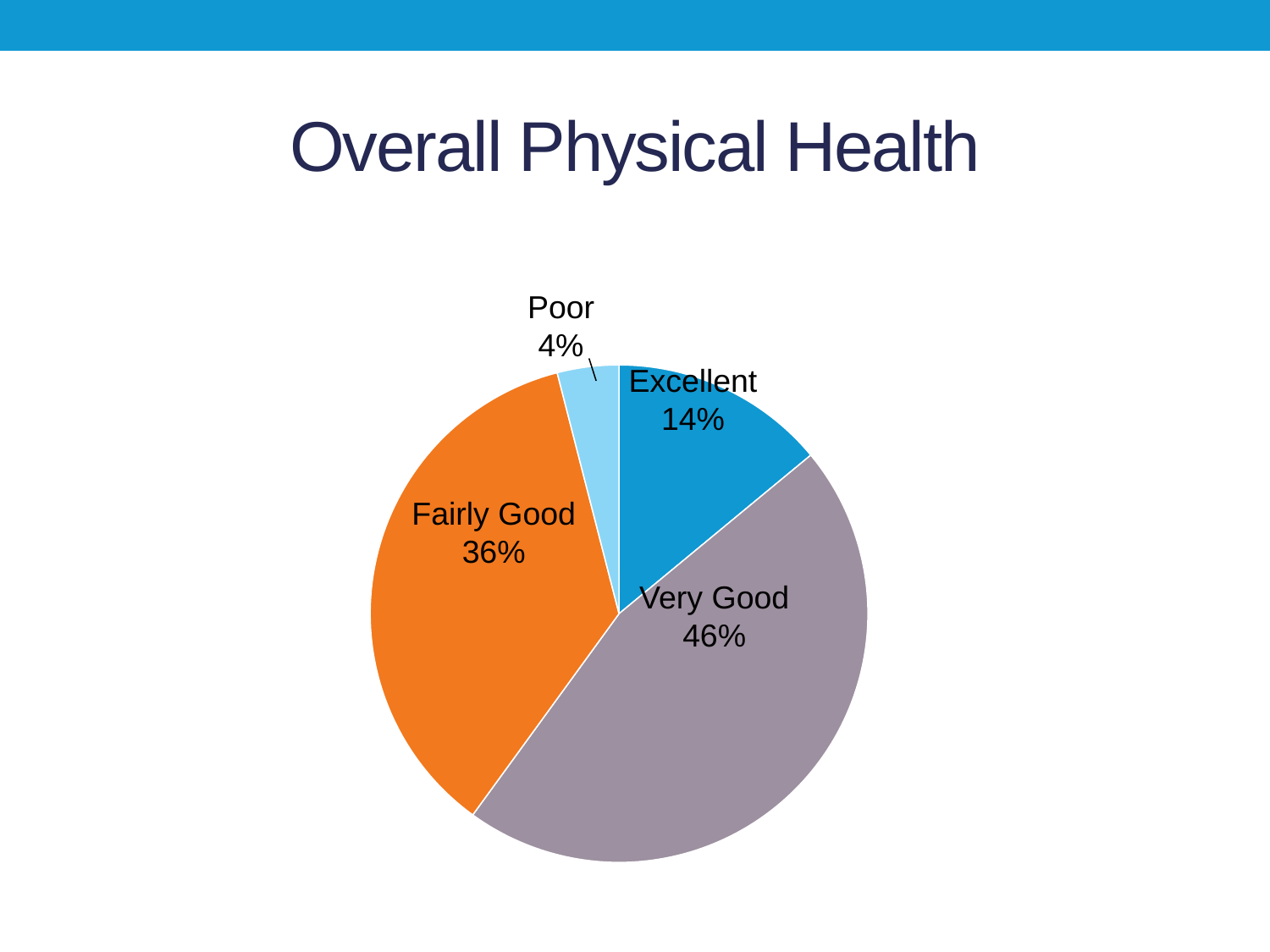
Which category has the largest slice of the pie? Very Good What is the title of the chart on the slide? Overall Physical Health What kind of chart is shown on the slide? pie chart What is the value shown for Fairly Good? 36% Which category has the smallest slice of the pie? Poor What is the difference between the Excellent and Poor shares? 10% Which is larger, the Excellent slice or the Fairly Good slice? Fairly Good What is the value shown for Excellent? 14% What is the value shown for Poor? 4% How many categories are shown in the pie chart? 4 What is the difference between the Very Good and Fairly Good shares? 10% What share of the pie is labelled Very Good? 46%